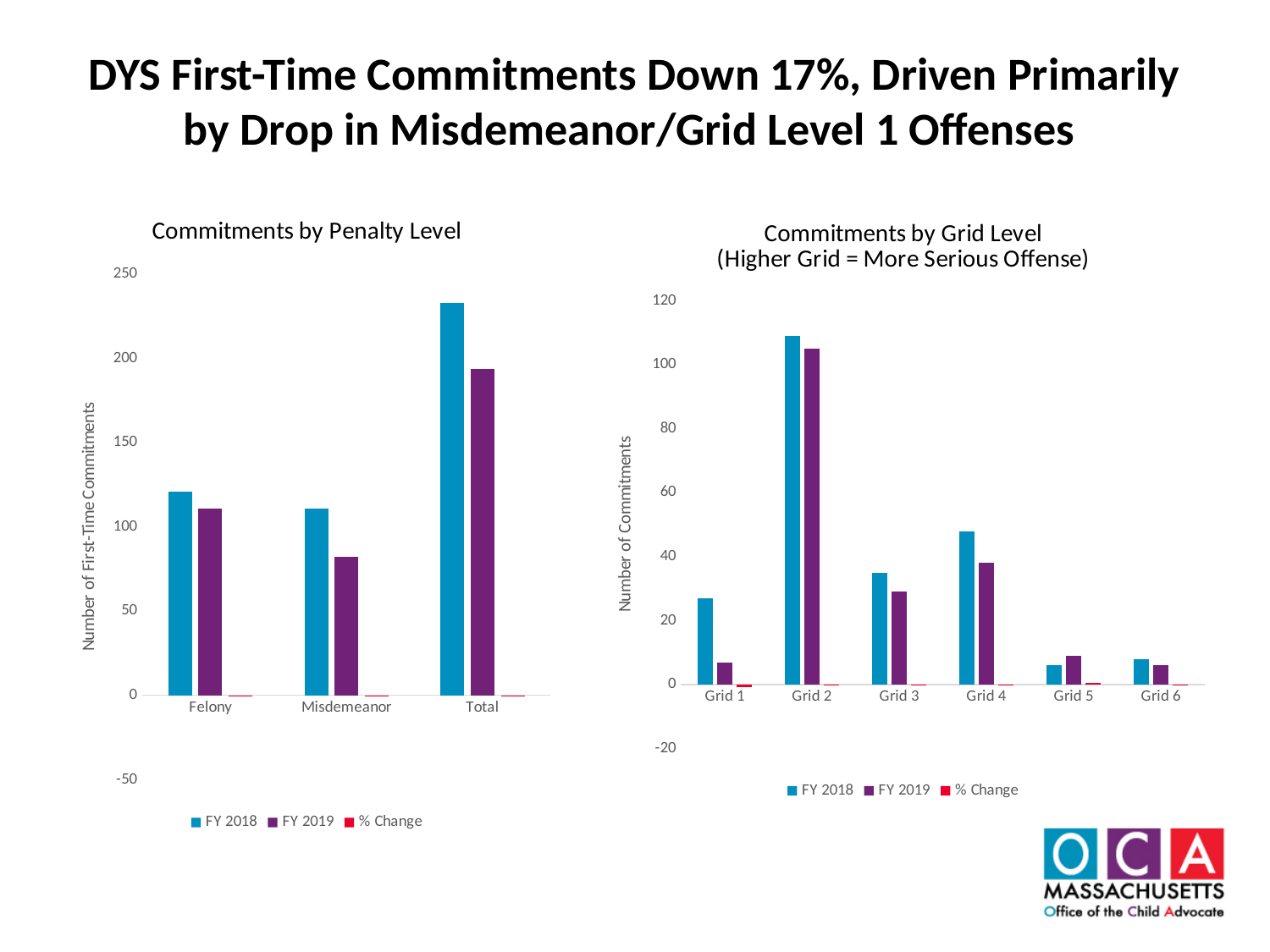
What kind of chart is the "Commitments by Penalty Level" chart on the left? bar chart In the "Commitments by Grid Level" chart, which grid level has the highest FY 2018 value? Grid 2 How many grid level categories are shown on the x axis of the "Commitments by Grid Level" chart? 6 In the "Commitments by Penalty Level" chart, is the FY 2018 value for Total greater or less than 200? greater In the "Commitments by Penalty Level" chart, is the FY 2019 value for Misdemeanor greater or less than 100? less In the "Commitments by Grid Level" chart, which is larger for Grid 5: FY 2018 or FY 2019? FY 2019 In the "Commitments by Penalty Level" chart, which is larger for FY 2018: Felony or Misdemeanor? Felony In the "Commitments by Penalty Level" chart, which category has the highest FY 2019 value? Total What is the y-axis label of the "Commitments by Grid Level" chart? Number of Commitments How many series does the legend of the "Commitments by Penalty Level" chart list? 3 In the "Commitments by Grid Level" chart, is the FY 2019 value for Grid 1 greater or less than 20? less